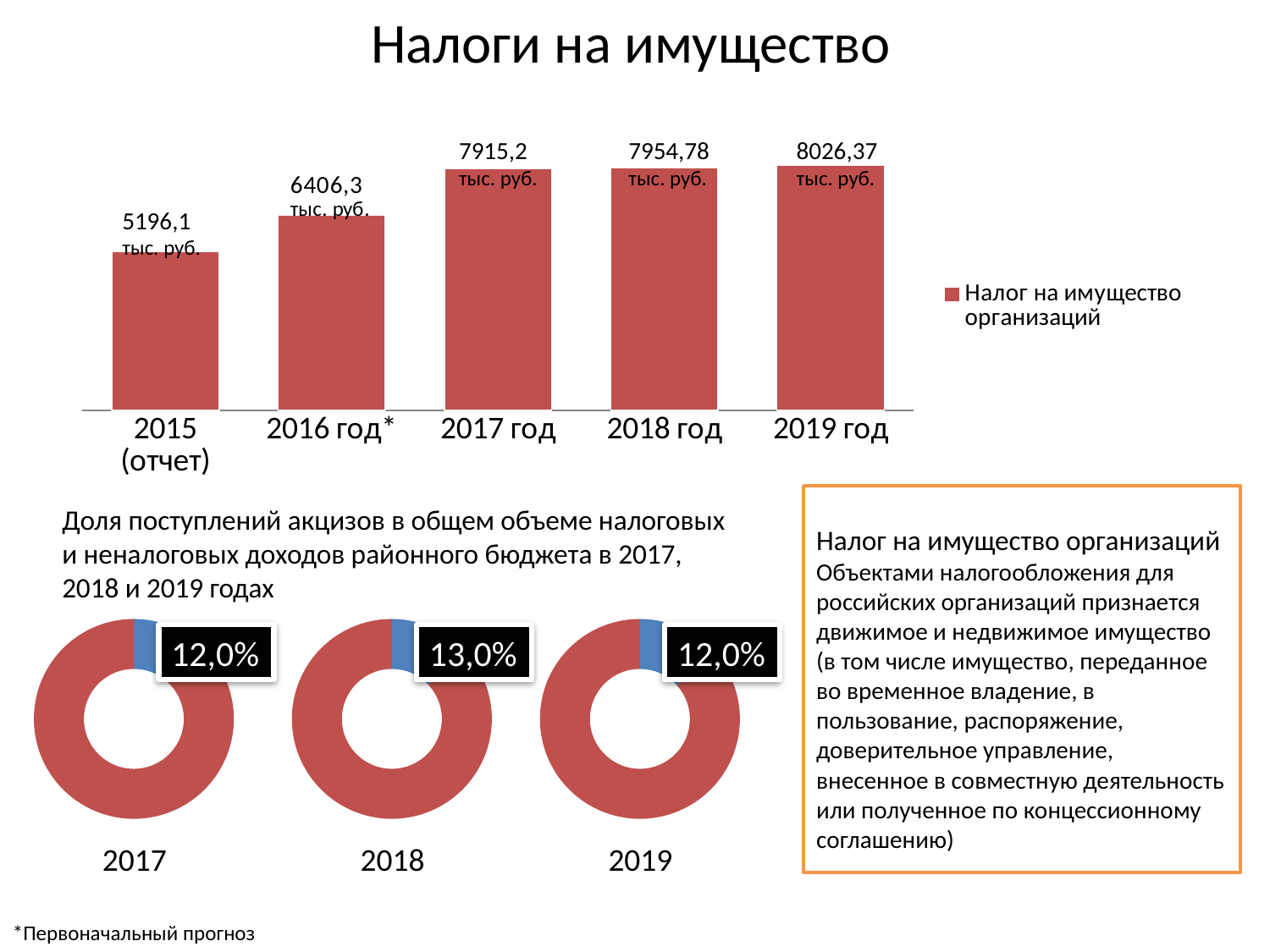
In the bar chart 'Налоги на имущество', how many bars are plotted? 5 What type of chart is the top chart 'Налоги на имущество'? bar chart In the bar chart 'Налоги на имущество', which year has the highest value? 2019 год In the bar chart 'Налоги на имущество', what series does the legend list? Налог на имущество организаций In the bar chart 'Налоги на имущество', what is the difference between the values for 2016 год* and 2015 (отчет)? 1210,2 тыс. руб. In the bar chart 'Налоги на имущество', which year has the lowest value? 2015 (отчет) In the donut chart for 2018 at the bottom of the slide, what share is shown by the data label? 13,0% In the bar chart 'Налоги на имущество', what is the value for 2019 год? 8026,37 тыс. руб. In the bar chart 'Налоги на имущество', what is the value for 2017 год? 7915,2 тыс. руб. In the bar chart 'Налоги на имущество', do the values rise or fall from 2015 to 2019? rise In the bar chart 'Налоги на имущество', what is the difference between the values for 2019 год and 2015 (отчет)? 2830,27 тыс. руб. In the bar chart 'Налоги на имущество', what is the value for 2015 (отчет)? 5196,1 тыс. руб.